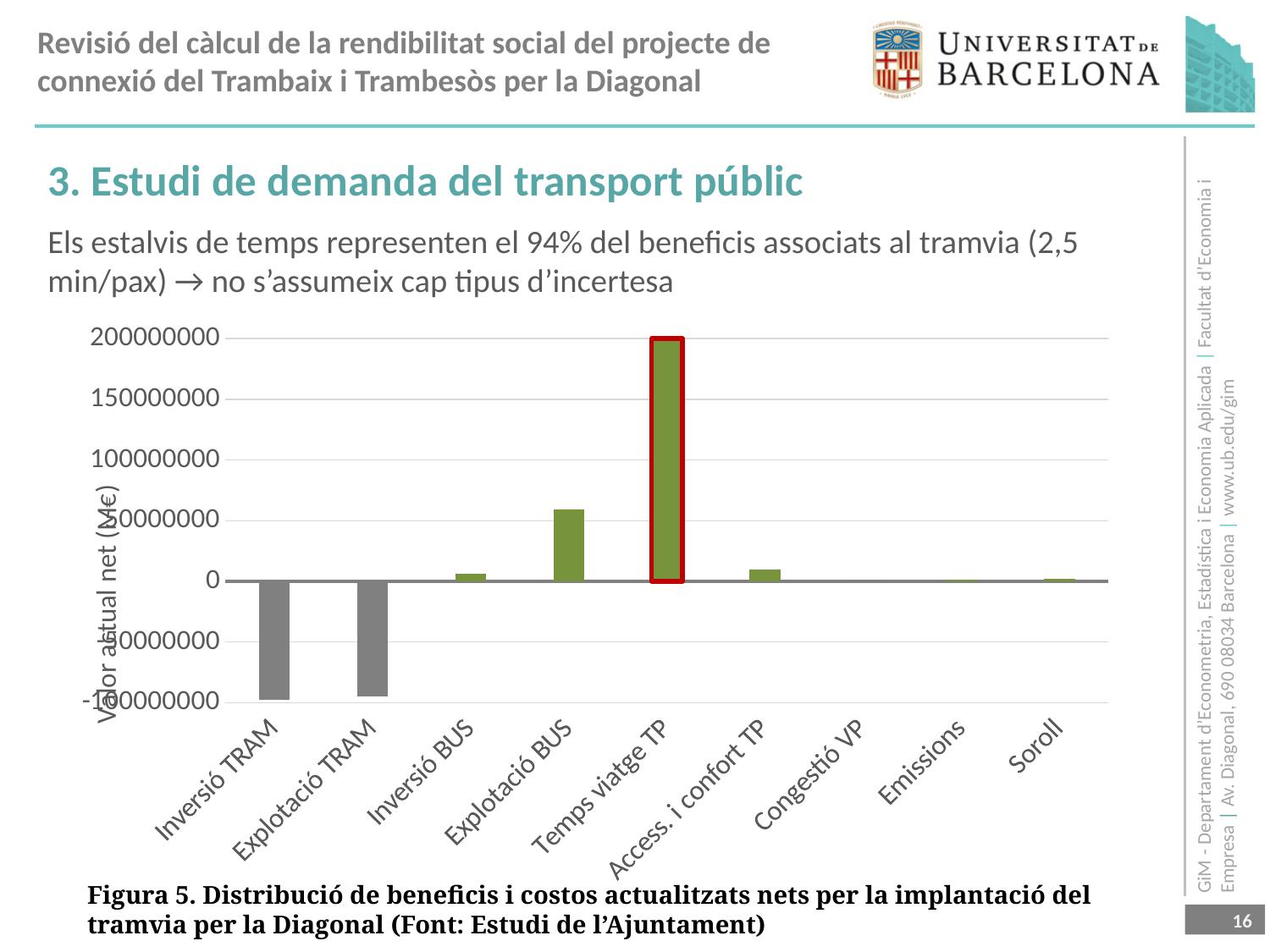
Which is larger, the value for Explotació BUS or the value for Congestió VP? Explotació BUS Which is larger, the value for Inversió BUS or the value for Explotació BUS? Explotació BUS Is the value for Temps viatge TP greater or less than 150000000? greater What is the title of the vertical axis of the chart? Valor actual net (M€) Which category has the highest value in the chart? Temps viatge TP What kind of chart is shown on the slide? bar chart How many categories are shown on the x axis of the chart? 9 Is the value for Inversió TRAM greater or less than -50000000? less How many categories in the chart have negative values? 2 Which bar in the chart is outlined in red? Temps viatge TP Is the value for Explotació BUS greater or less than 50000000? greater